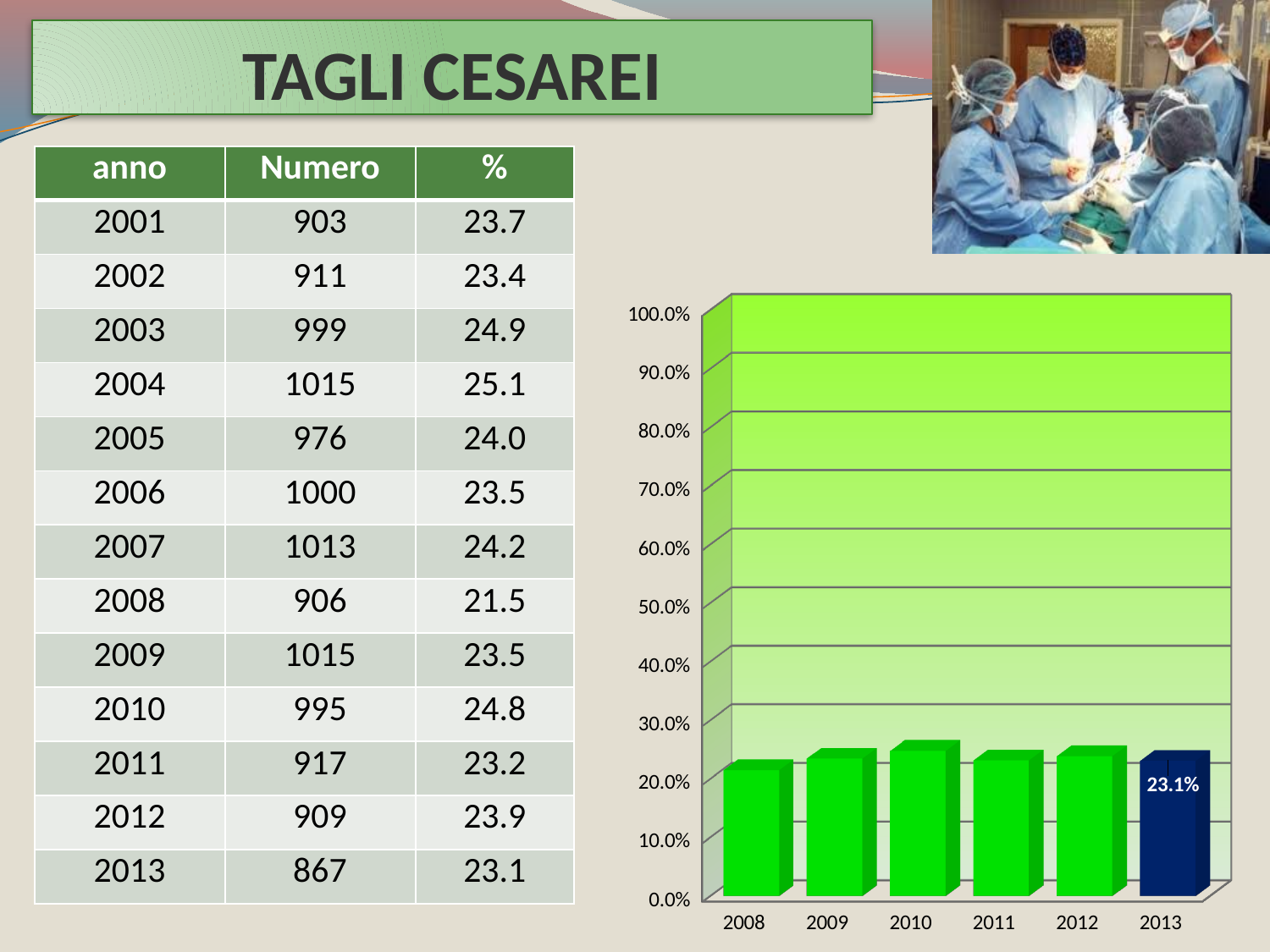
Which year has the lowest bar in the chart? 2008 Is the value for 2009 greater or less than 10.0%? greater Is the value for 2012 greater or less than 50.0%? less Is the value for 2008 greater or less than 30.0%? less What value is labelled on the bar for 2013? 23.1% Which is larger, the value for 2010 or the value for 2008? 2010 Which is larger, the value for 2013 or the value for 2010? 2010 What kind of chart is shown on the slide? bar chart Which year's bar is coloured dark blue instead of green? 2013 How many years are shown on the x axis of the chart? 6 What is the highest value shown on the chart's vertical axis? 100.0%